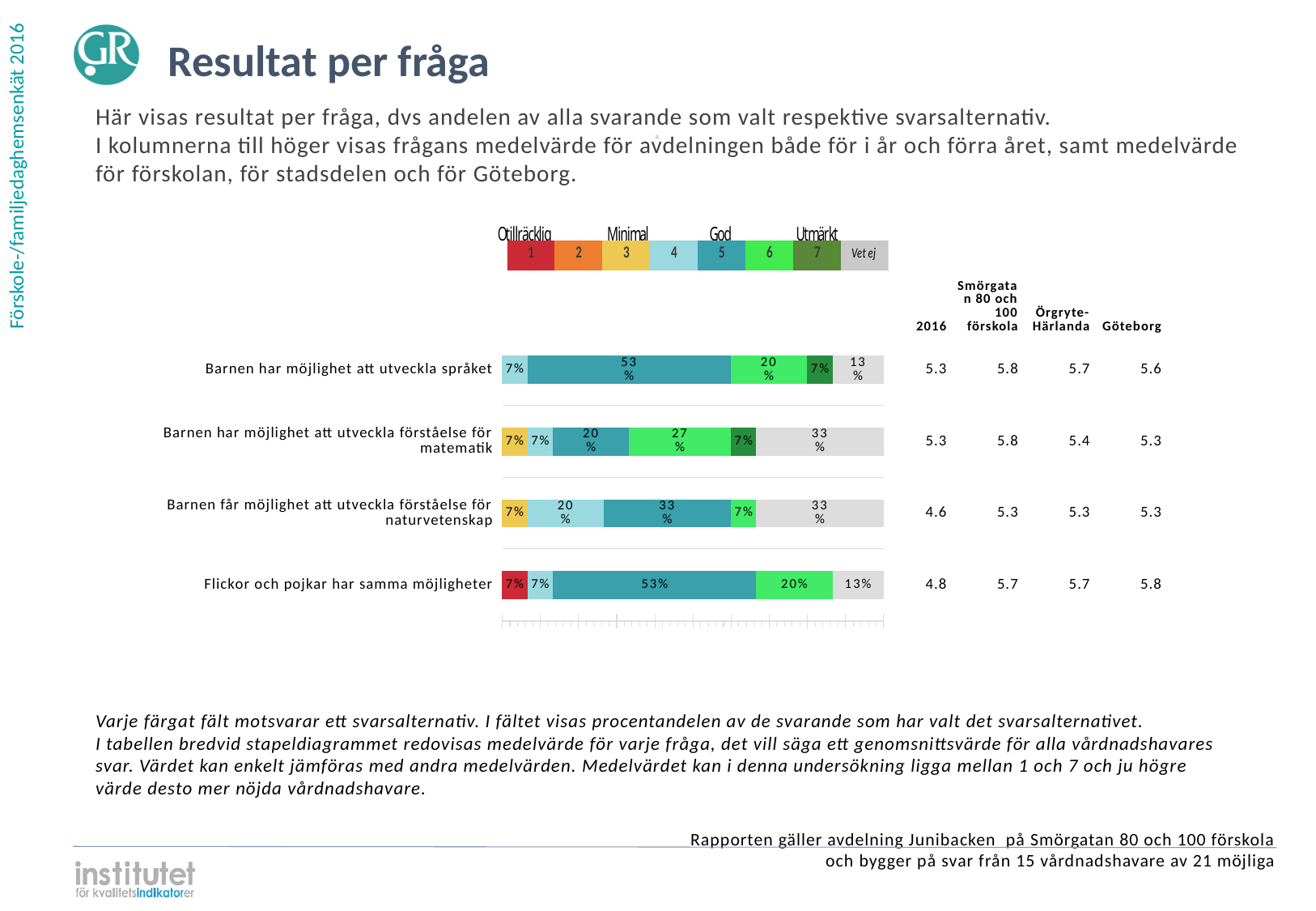
How many response options does the legend above the chart list? 8 What is the difference between the option 5 (teal) share for 'Flickor och pojkar har samma möjligheter' and for 'Barnen får möjlighet att utveckla förståelse för naturvetenskap'? 20% What kind of chart is shown on the slide? bar chart Which question has the largest share of option 4 (light blue) responses? Barnen får möjlighet att utveckla förståelse för naturvetenskap What percentage of respondents chose option 5 (teal) for 'Barnen har möjlighet att utveckla språket'? 53% What is the 2016 mean value shown for 'Barnen får möjlighet att utveckla förståelse för naturvetenskap'? 4.6 What label does the legend give to the grey segment at the end of each bar? Vet ej How many questions (categories) are plotted in the bar chart? 4 What percentage chose option 1 (red) for 'Flickor och pojkar har samma möjligheter'? 7% What percentage chose 'Vet ej' for 'Barnen har möjlighet att utveckla förståelse för matematik'? 33% What percentage chose option 6 (bright green) for 'Barnen har möjlighet att utveckla förståelse för matematik'? 27% Which is larger: the 'Vet ej' share for 'Barnen har möjlighet att utveckla språket' or for 'Barnen får möjlighet att utveckla förståelse för naturvetenskap'? Barnen får möjlighet att utveckla förståelse för naturvetenskap